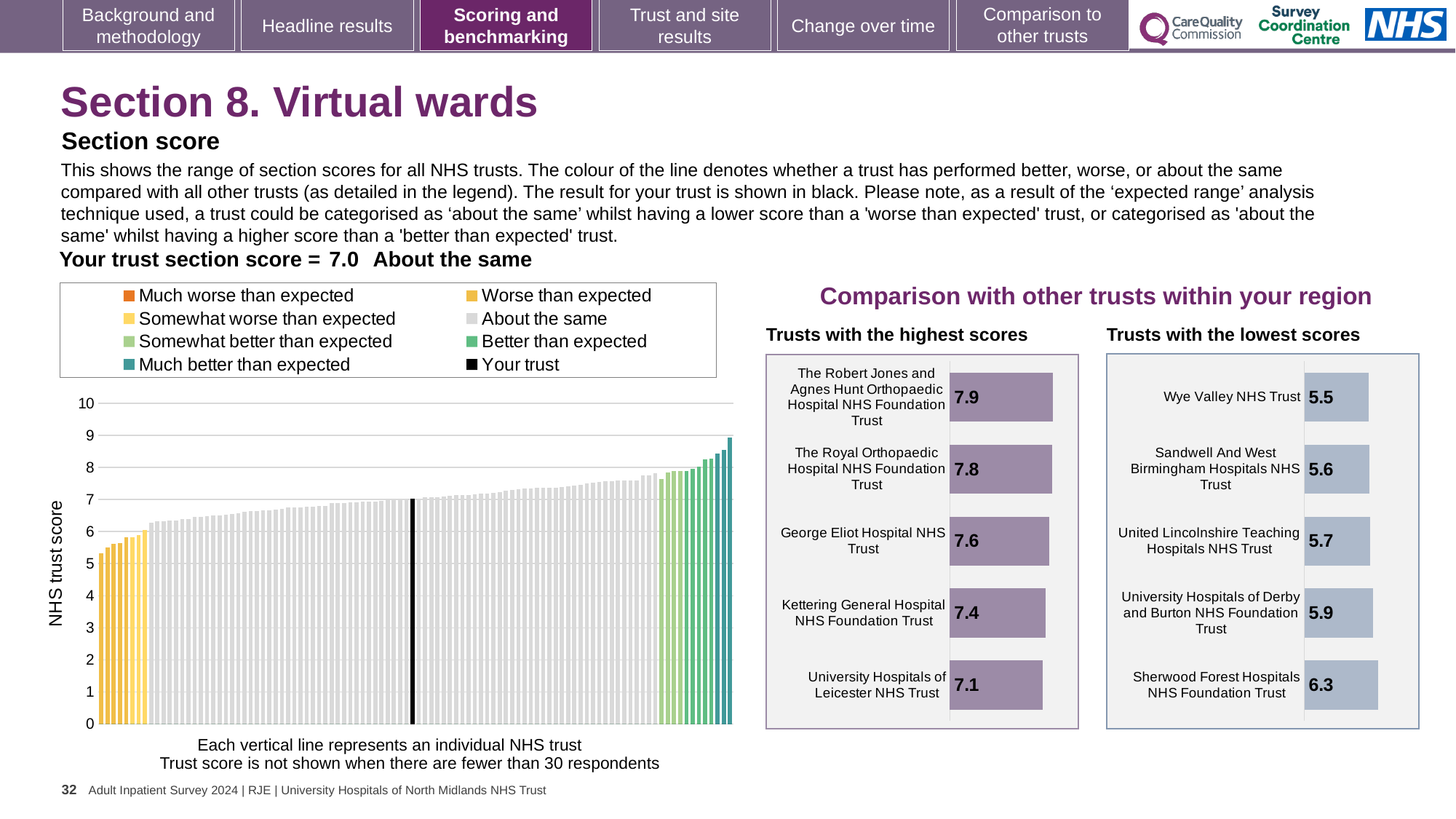
In the 'Trusts with the highest scores' chart, which trust has the highest score? The Robert Jones and Agnes Hunt Orthopaedic Hospital NHS Foundation Trust In the NHS trust score chart on the left, is the value of the tallest bar greater or less than 8? greater In the 'Trusts with the lowest scores' chart, what is the score for Sherwood Forest Hospitals NHS Foundation Trust? 6.3 How many trusts are shown in the 'Trusts with the lowest scores' chart? 5 How many entries does the legend of the NHS trust score chart on the left list? 8 What kind of chart is the NHS trust score chart on the left? Bar chart In the 'Trusts with the lowest scores' chart, what is the difference between the scores of Sherwood Forest Hospitals NHS Foundation Trust and Wye Valley NHS Trust? 0.8 In the 'Trusts with the highest scores' chart, what is the score for George Eliot Hospital NHS Trust? 7.6 In the 'Trusts with the highest scores' chart, which has the higher score: The Royal Orthopaedic Hospital NHS Foundation Trust or Kettering General Hospital NHS Foundation Trust? The Royal Orthopaedic Hospital NHS Foundation Trust In the 'Trusts with the highest scores' chart, what is the difference between the scores of The Robert Jones and Agnes Hunt Orthopaedic Hospital NHS Foundation Trust and University Hospitals of Leicester NHS Trust? 0.8 In the NHS trust score chart on the left, what is the section score for your trust? 7.0 In the 'Trusts with the lowest scores' chart, which trust has the lowest score? Wye Valley NHS Trust